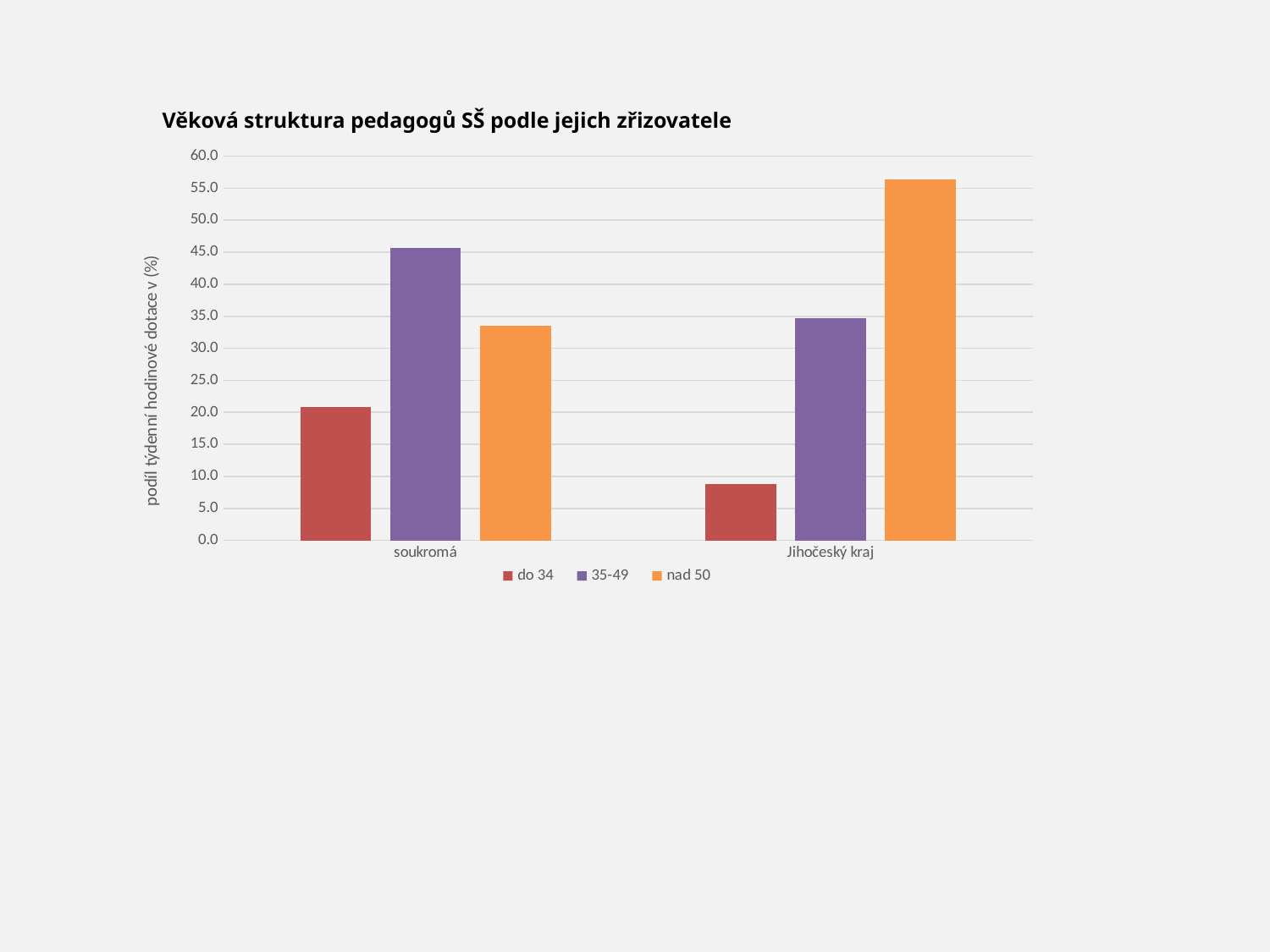
Which series has the highest value for Jihočeský kraj? nad 50 Which is larger: the do 34 value for soukromá or the do 34 value for Jihočeský kraj? soukromá Which is larger: the nad 50 value for soukromá or the nad 50 value for Jihočeský kraj? Jihočeský kraj What is the title of the chart? Věková struktura pedagogů SŠ podle jejich zřizovatele Which series has the lowest value for Jihočeský kraj? do 34 Which series has the highest value for soukromá? 35-49 What kind of chart is shown on the slide? bar chart Is the do 34 value for Jihočeský kraj greater or less than 10.0? less How many categories are shown on the x axis? 2 Is the nad 50 value for Jihočeský kraj greater or less than 55.0? greater How many series does the legend list? 3